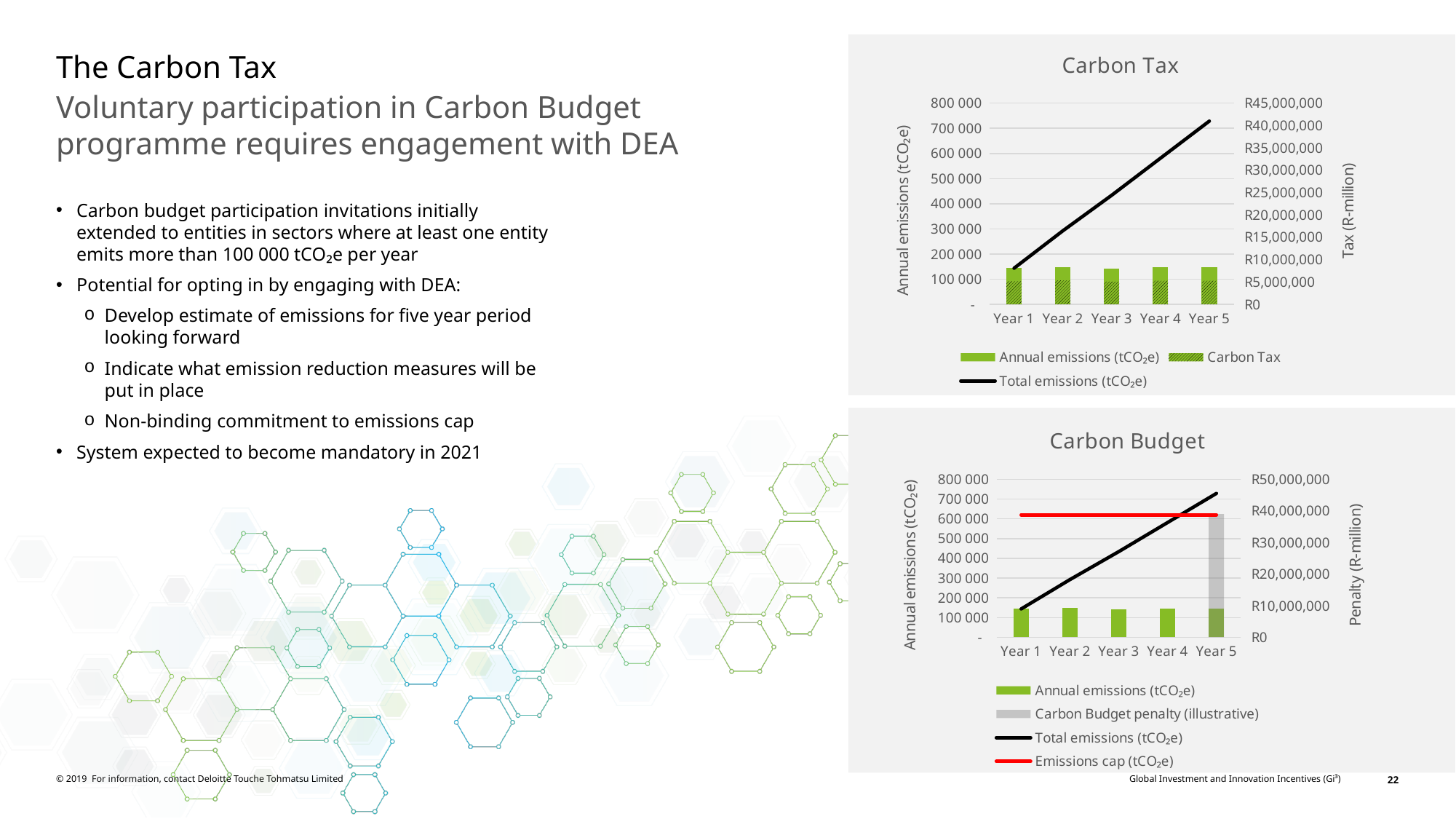
On the Carbon Budget chart, what is the label of the right-hand vertical axis? Penalty (R-million) What kind of chart is the Carbon Tax chart? bar and line chart On the Carbon Budget chart, is the Emissions cap line greater or less than 500 000? greater On the Carbon Budget chart, how many series does the legend list? 4 On the Carbon Budget chart, is the Total emissions value for Year 5 greater or less than 600 000? greater On the Carbon Budget chart, in which year is Total emissions highest? Year 5 On the Carbon Tax chart, does the Total emissions line rise or fall from Year 1 to Year 5? rise On the Carbon Tax chart, is the Annual emissions value for Year 3 greater or less than 100 000? greater On the Carbon Tax chart, how many years are shown on the x axis? 5 On the Carbon Tax chart, how many series does the legend list? 3 On the Carbon Budget chart, which is larger: Total emissions in Year 1 or in Year 5? Year 5